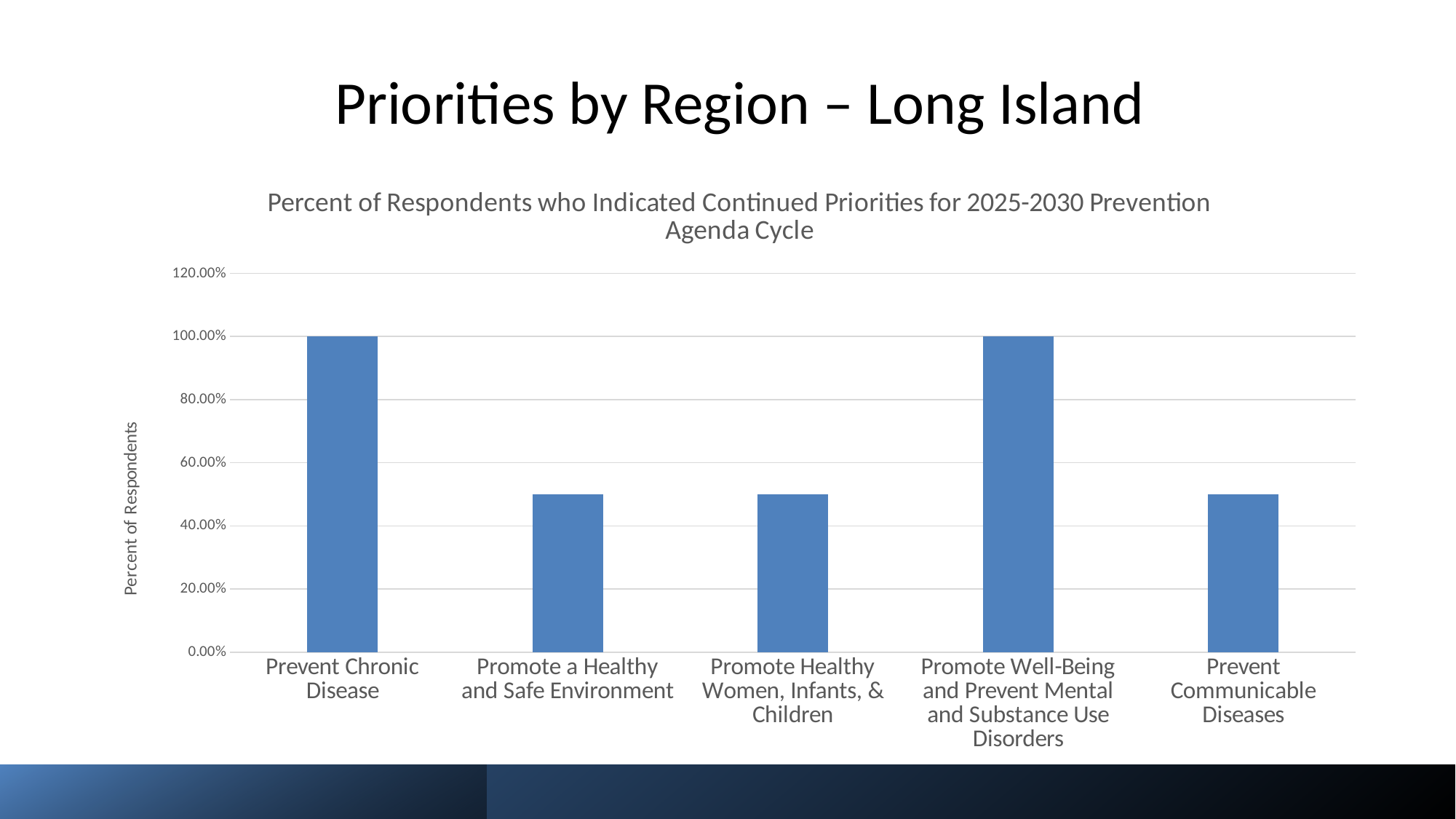
What type of chart is shown on the slide? Bar chart What is the value for Promote Well-Being and Prevent Mental and Substance Use Disorders? 100.00% What is the value for Prevent Chronic Disease? 100.00% Is the value for Prevent Communicable Diseases greater or less than 40.00%? greater How many categories are shown on the x axis of the chart? 5 Is the value for Promote Healthy Women, Infants, & Children greater or less than 80.00%? less Which is larger, the value for Prevent Communicable Diseases or the value for Promote Well-Being and Prevent Mental and Substance Use Disorders? Promote Well-Being and Prevent Mental and Substance Use Disorders What is the difference between the values for Prevent Chronic Disease and Promote Well-Being and Prevent Mental and Substance Use Disorders? 0.00% Which is larger, the value for Prevent Chronic Disease or the value for Promote a Healthy and Safe Environment? Prevent Chronic Disease What is the title of the chart? Percent of Respondents who Indicated Continued Priorities for 2025-2030 Prevention Agenda Cycle Is the value for Promote a Healthy and Safe Environment greater or less than 60.00%? less What is the label on the y axis of the chart? Percent of Respondents